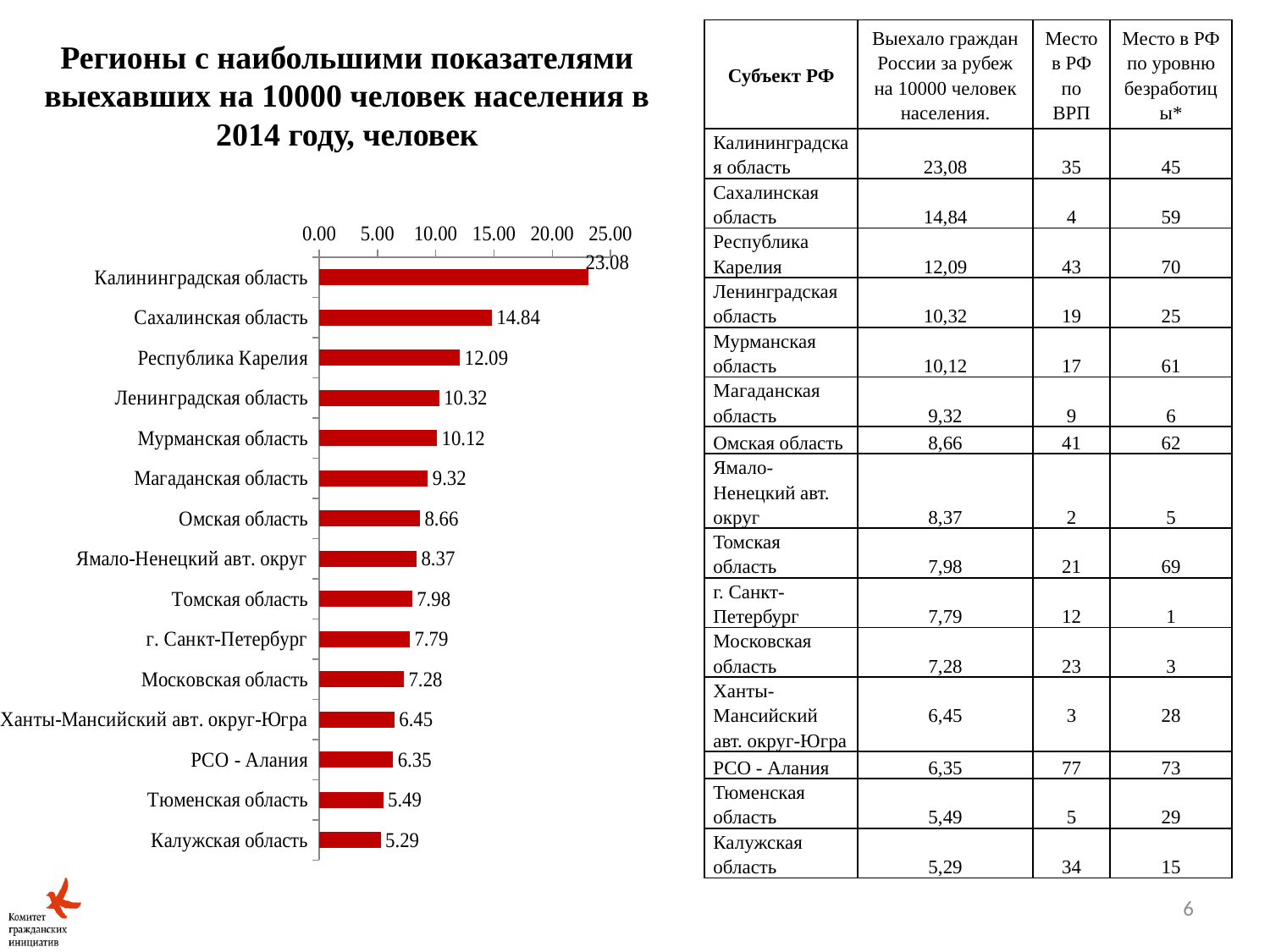
What is the difference between the values for Калининградская область and Сахалинская область? 8.24 What is the value for Калужская область in the chart? 5.29 What is the value for Калининградская область in the chart? 23.08 Which has a larger value, Мурманская область or Магаданская область? Мурманская область What is the value for Ямало-Ненецкий авт. округ in the chart? 8.37 What type of chart is shown on the slide? bar chart Which region has the highest value in the chart? Калининградская область Which region has the lowest value in the chart? Калужская область How many regions are shown in the chart? 15 What is the value for Сахалинская область in the chart? 14.84 Do the bar values increase or decrease going from the top of the chart to the bottom? decrease Is the value for Омская область greater or less than 10.00? less